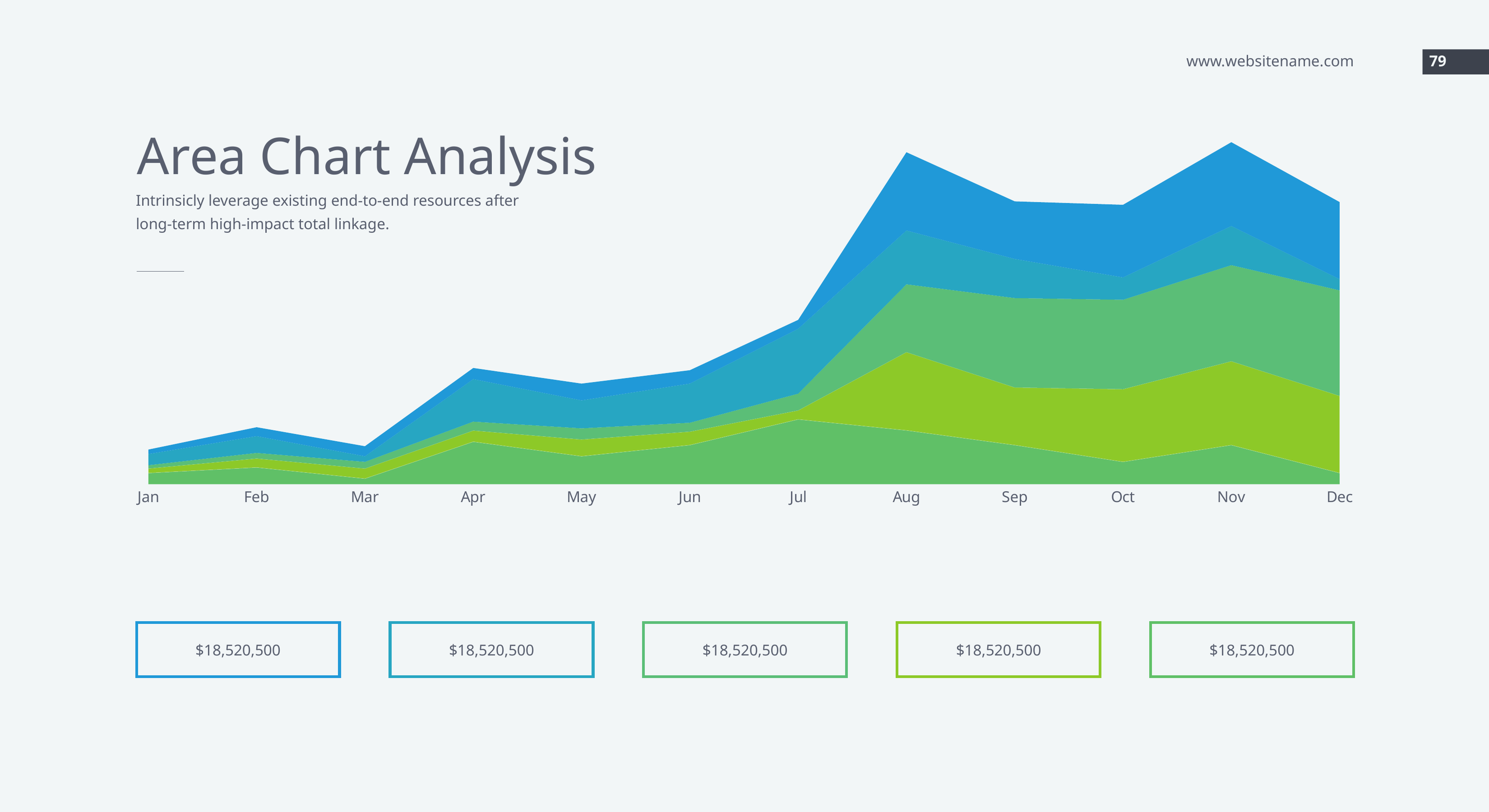
Is the total stacked value in Dec larger or smaller than in Jan? Larger What kind of chart is shown on the slide? Area chart Do the total stacked values generally rise or fall from Jan to Aug? Rise What is the title of the chart slide? Area Chart Analysis Which month is the first category on the x axis? Jan How many months are shown along the x axis of the area chart? 12 Is the total stacked value in Aug larger or smaller than in Jul? Larger Is the total stacked value in Sep larger or smaller than in Apr? Larger Which month has the highest total stacked value in the area chart? Nov